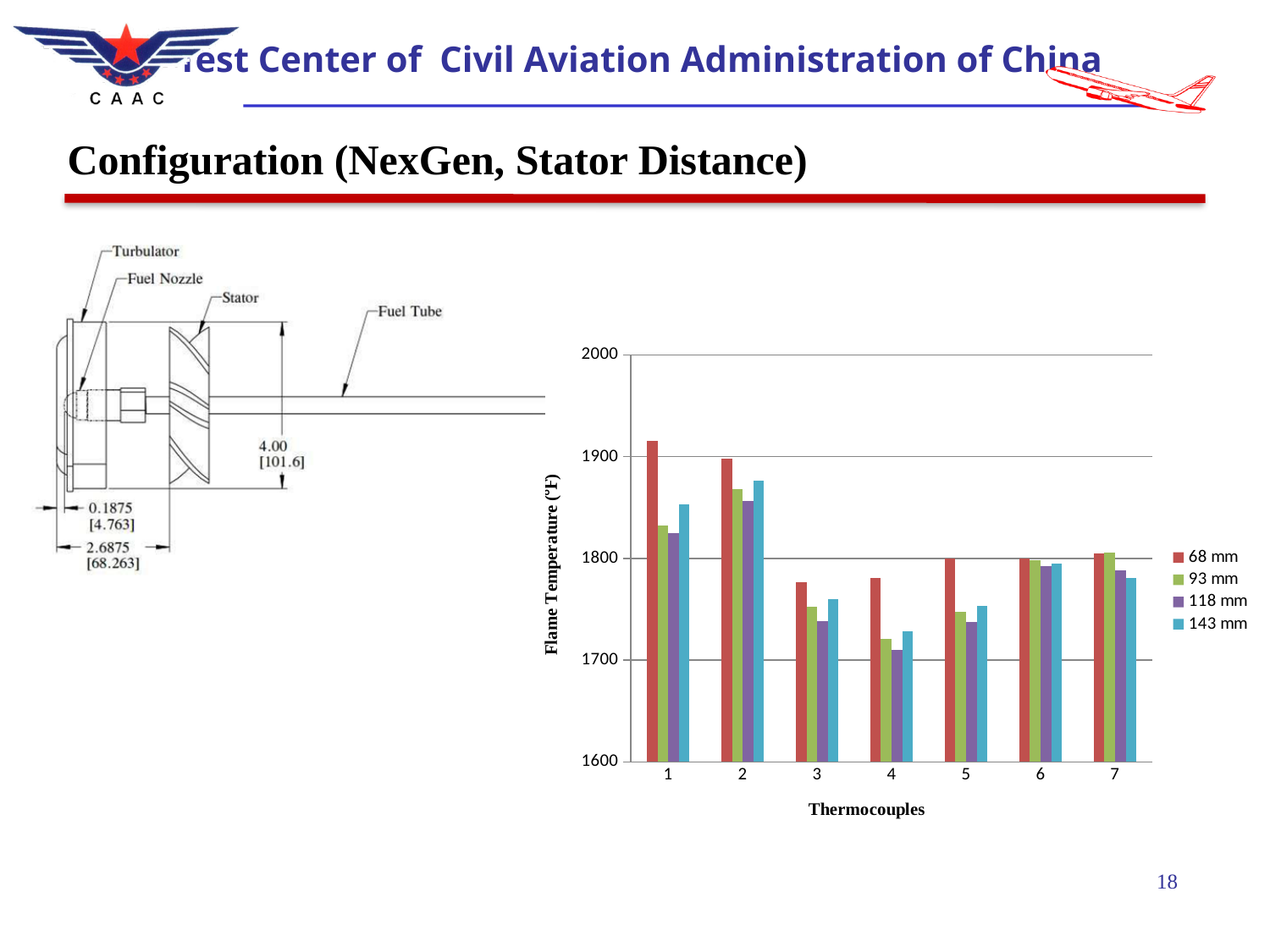
What is the title of the chart's vertical axis? Flame Temperature (°F) How many thermocouples are shown along the x axis of the chart? 7 What kind of chart is shown on the slide? bar chart Is the 68 mm value at thermocouple 1 greater or less than 1900? greater At which thermocouple is the 68 mm series highest? 1 At which thermocouple is the 93 mm series lowest? 4 Is the 68 mm value at thermocouple 3 greater or less than 1800? less How many series does the chart's legend list? 4 At thermocouple 4, which is larger: the 118 mm value or the 143 mm value? 143 mm From thermocouple 1 to thermocouple 4, does the 68 mm series rise or fall? fall Is the 143 mm value at thermocouple 1 greater or less than 1900? less At thermocouple 1, which is larger: the 68 mm value or the 93 mm value? 68 mm